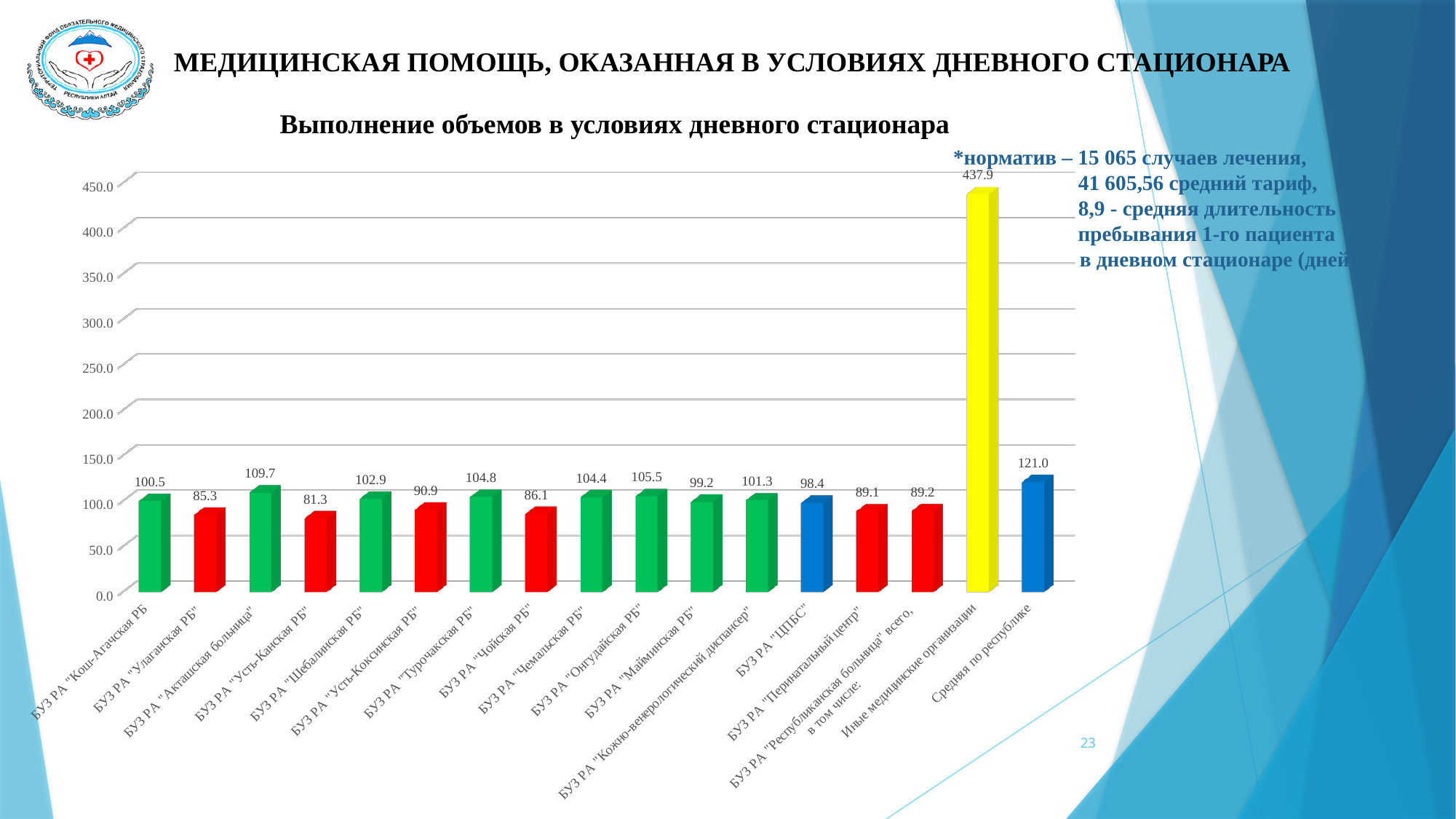
How many categories are shown on the x axis? 17 What is the value for Средняя по республике? 121.0 Is the value for БУЗ РА "Чойская РБ" greater or less than 100.0? less What is the difference between the values for БУЗ РА "Акташская больница" and БУЗ РА "Улаганская РБ"? 24.4 What is the value for Иные медицинские организации? 437.9 What is the title of the chart? Выполнение объемов в условиях дневного стационара Which category has the lowest value? БУЗ РА "Усть-Канская РБ" What is the value for БУЗ РА "Усть-Коксинская РБ"? 90.9 Which is larger, the value for БУЗ РА "Онгудайская РБ" or БУЗ РА "Майминская РБ"? БУЗ РА "Онгудайская РБ" Which category has the highest value? Иные медицинские организации What is the value for БУЗ РА "Кош-Агачская РБ"? 100.5 What kind of chart is shown on the slide? bar chart